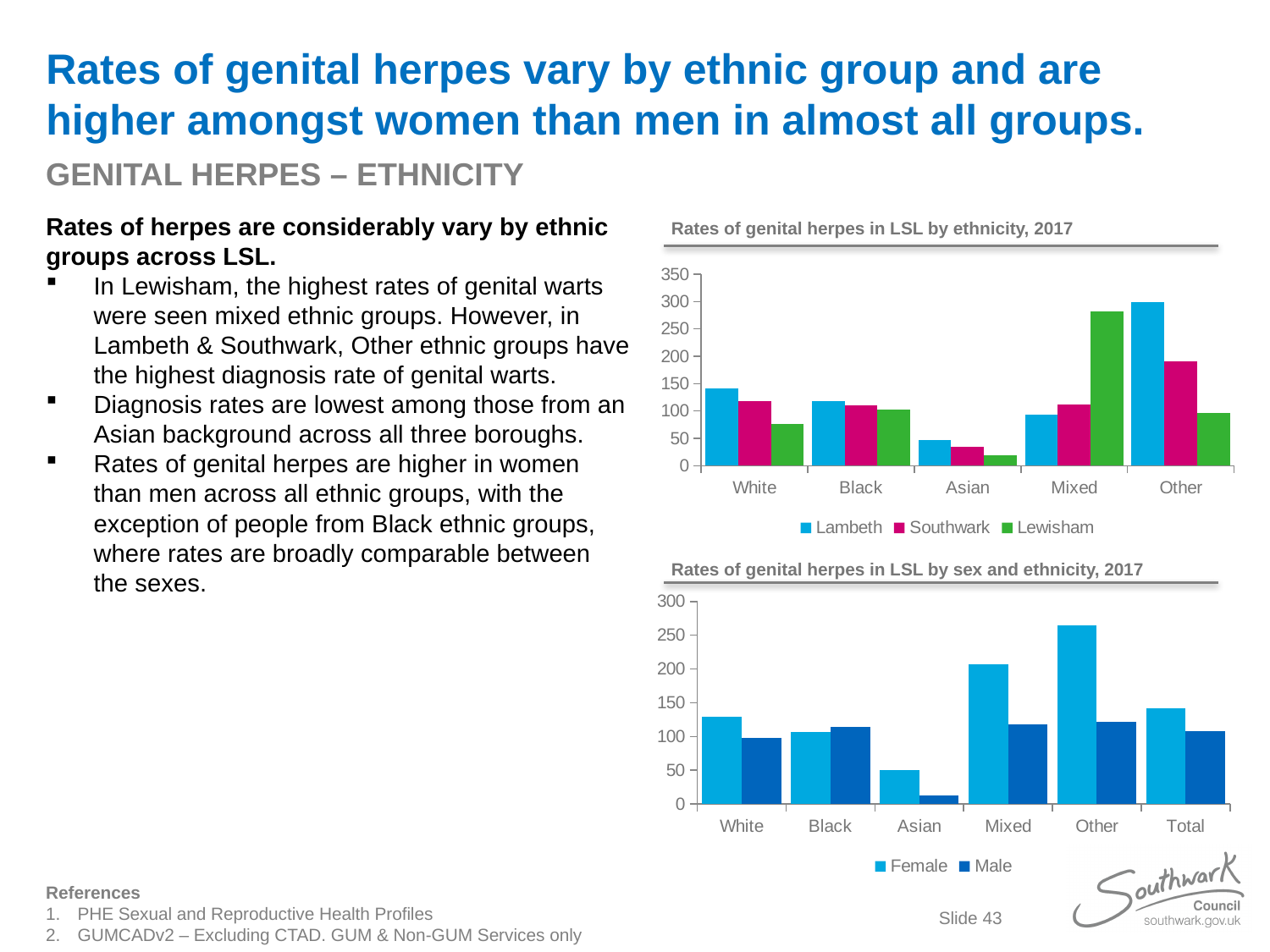
In the chart 'Rates of genital herpes in LSL by ethnicity, 2017', which is larger for White: Lambeth or Lewisham? Lambeth In the chart 'Rates of genital herpes in LSL by ethnicity, 2017', which ethnic group has the lowest Lewisham value? Asian In the chart 'Rates of genital herpes in LSL by ethnicity, 2017', which ethnic group has the highest Lambeth value? Other In the chart 'Rates of genital herpes in LSL by sex and ethnicity, 2017', is the Male value for Asian greater or less than 50? less In the chart 'Rates of genital herpes in LSL by ethnicity, 2017', is the Lewisham value for Mixed greater or less than 250? greater In the chart 'Rates of genital herpes in LSL by ethnicity, 2017', how many ethnic groups are shown on the x axis? 5 In the chart 'Rates of genital herpes in LSL by sex and ethnicity, 2017', how many categories are shown on the x axis? 6 In the chart 'Rates of genital herpes in LSL by ethnicity, 2017', is the Southwark value for Other greater or less than 150? greater In the chart 'Rates of genital herpes in LSL by sex and ethnicity, 2017', which is larger for Mixed: Female or Male? Female In the chart 'Rates of genital herpes in LSL by ethnicity, 2017', how many series does the legend list? 3 In the chart 'Rates of genital herpes in LSL by sex and ethnicity, 2017', which category has the highest Female value? Other What kind of chart is 'Rates of genital herpes in LSL by sex and ethnicity, 2017'? bar chart